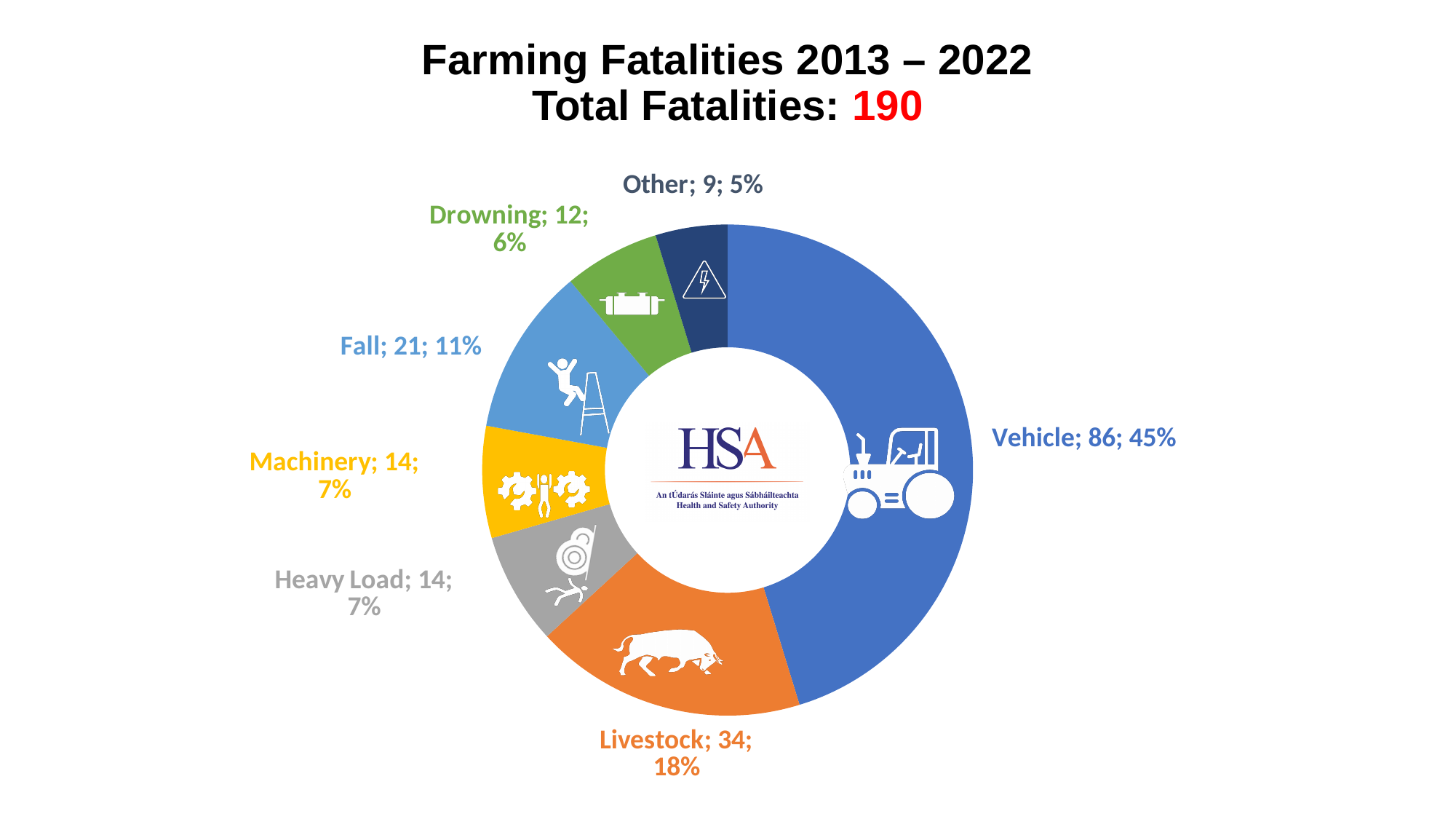
How many fatalities are attributed to Vehicle? 86 What share of the total do Drowning fatalities represent? 6% What colour is the Livestock slice? Orange Which category has the highest number of fatalities? Vehicle What is the difference between the Vehicle and Livestock fatalities? 52 Which category has the lowest number of fatalities? Other What is the total number of fatalities stated in the chart title? 190 What kind of chart is shown on the slide? Pie chart (doughnut) How many categories are shown in the chart? 7 What percentage share does Fall have? 11% How many fatalities are attributed to Livestock? 34 Which is larger, Fall or Drowning? Fall